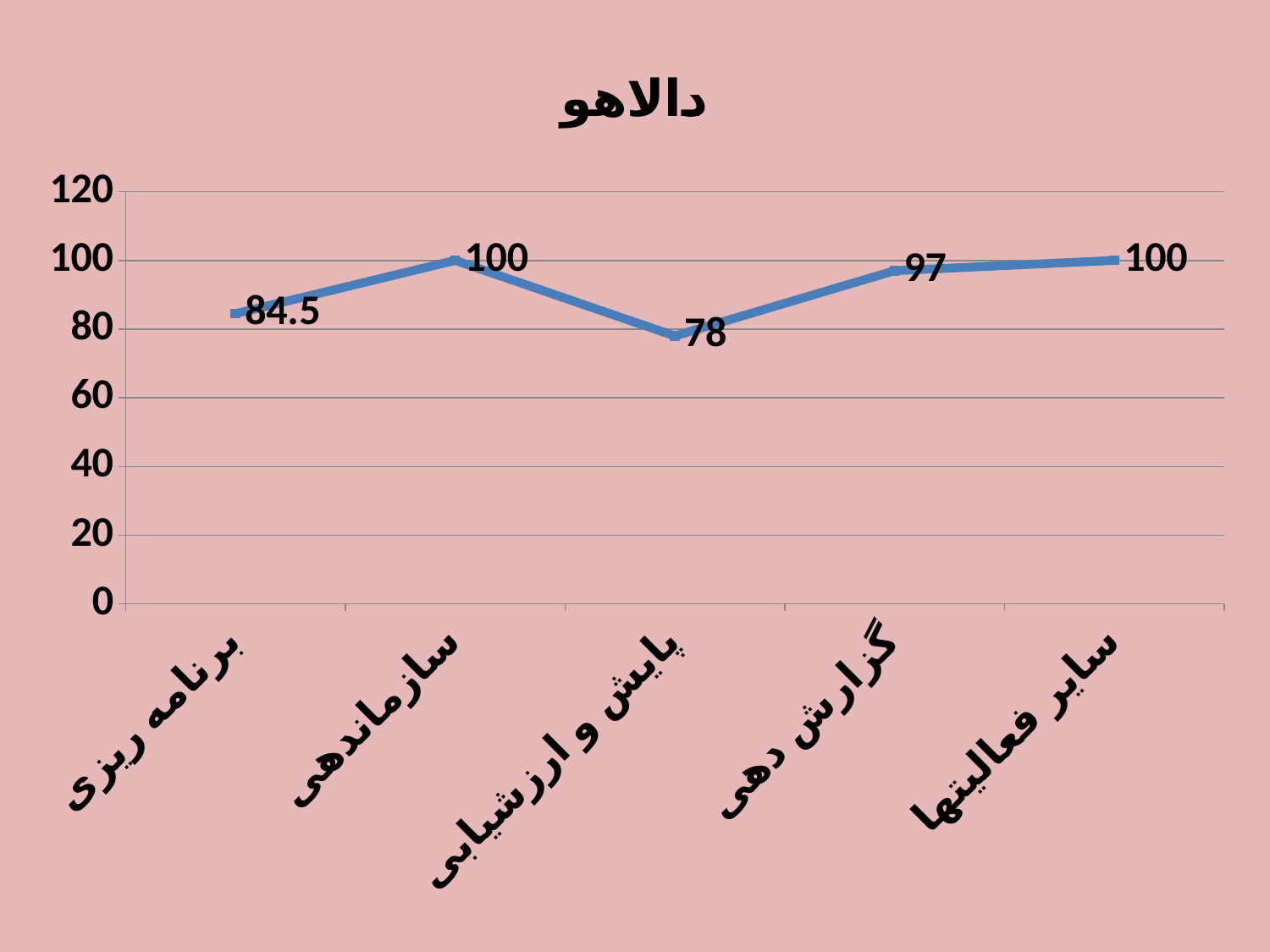
What is the difference between the values for گزارش دهی and برنامه ریزی? 12.5 What is the difference between the values for سازماندهی and پایش و ارزشیابی? 22 How many categories are plotted on the chart? 5 What is the value for برنامه ریزی? 84.5 What is the title of the chart? دالاهو What kind of chart is shown on the slide? line chart What is the highest value shown on the chart? 100 What is the value for گزارش دهی? 97 What is the value for سازماندهی? 100 Which is larger, the value for گزارش دهی or the value for برنامه ریزی? گزارش دهی Which category has the lowest value? پایش و ارزشیابی What is the value for پایش و ارزشیابی? 78